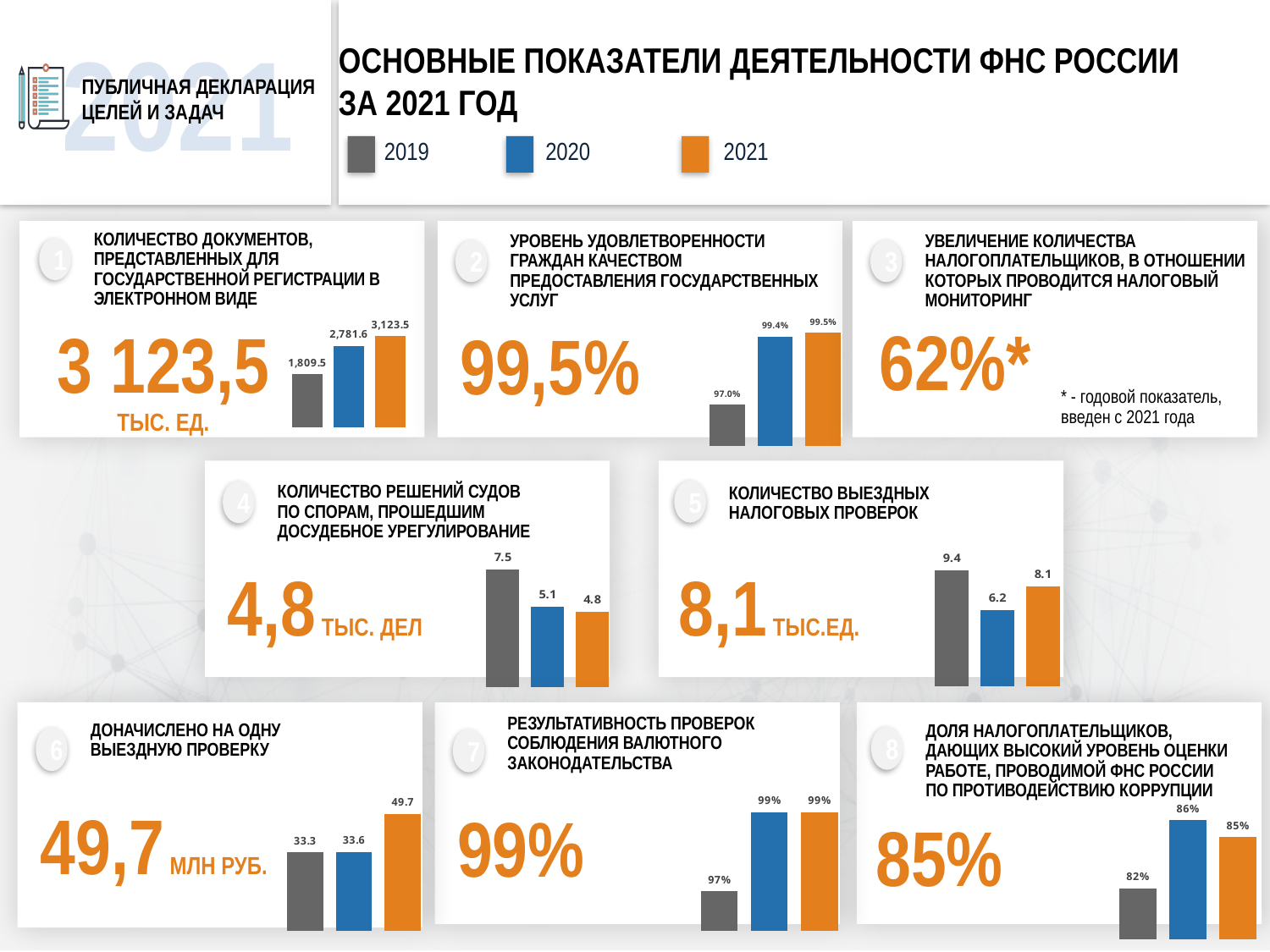
In the chart in panel 2 (Уровень удовлетворенности граждан...), what is the value for 2020? 99.4% In the chart in panel 5 (Количество выездных налоговых проверок), which year has the lowest value? 2020 In the chart in panel 5 (Количество выездных налоговых проверок), what is the value for 2021? 8.1 In the chart in panel 8 (Доля налогоплательщиков, дающих высокий уровень оценки...), which year has the highest value? 2020 In the chart in panel 1 (Количество документов, представленных для государственной регистрации в электронном виде), what is the value for 2019? 1,809.5 In the chart in panel 7 (Результативность проверок соблюдения валютного законодательства), what is the value for 2019? 97% In the chart in panel 4 (Количество решений судов по спорам...), what is the difference between the 2019 and 2021 values? 2.7 In the chart in panel 6 (Доначислено на одну выездную проверку), what is the difference between the 2021 and 2019 values? 16.4 How many years does the legend at the top of the slide list? 3 In the chart in panel 1 (Количество документов...), which year has the highest value? 2021 In the chart in panel 4 (Количество решений судов по спорам...), do the values rise or fall from 2019 to 2021? fall In the chart in panel 6 (Доначислено на одну выездную проверку), which is larger: the value for 2020 or the value for 2021? 2021